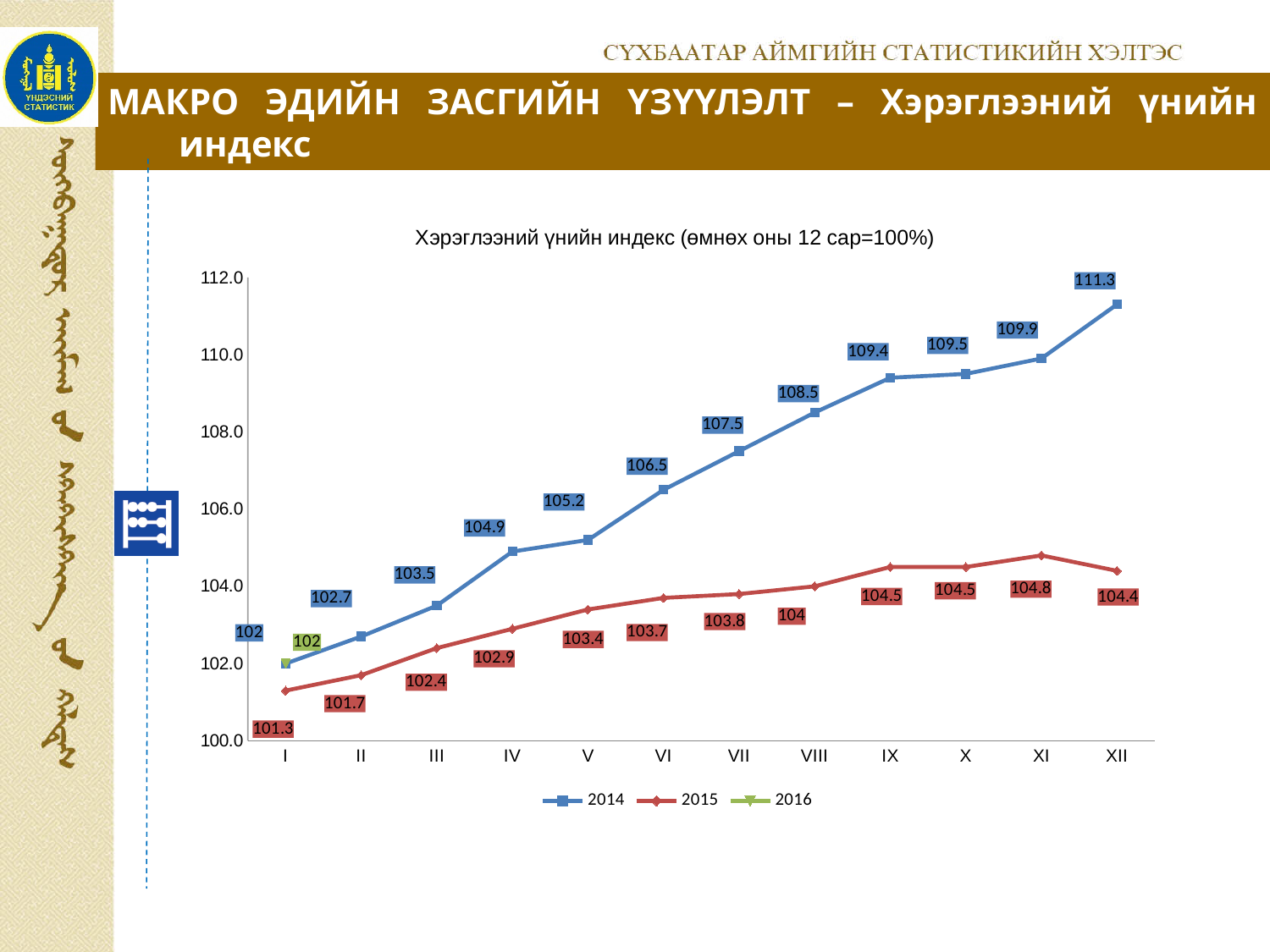
In which month is the 2015 series at its highest? XI Which is larger in month IV: the 2014 value or the 2015 value? 2014 What type of chart is shown on the slide? line chart What is the value for 2015 in month VIII? 104 In which month is the 2014 series at its lowest? I How many months are shown on the x axis? 12 What is the value for 2016 in month I? 102 Does the 2014 series rise or fall from month I to month XII? rise How many series does the legend list? 3 What is the value for 2014 in month XII? 111.3 What is the title of the chart? Хэрэглээний үнийн индекс (өмнөх оны 12 сар=100%) What is the difference between the 2014 and 2015 values in month XII? 6.9